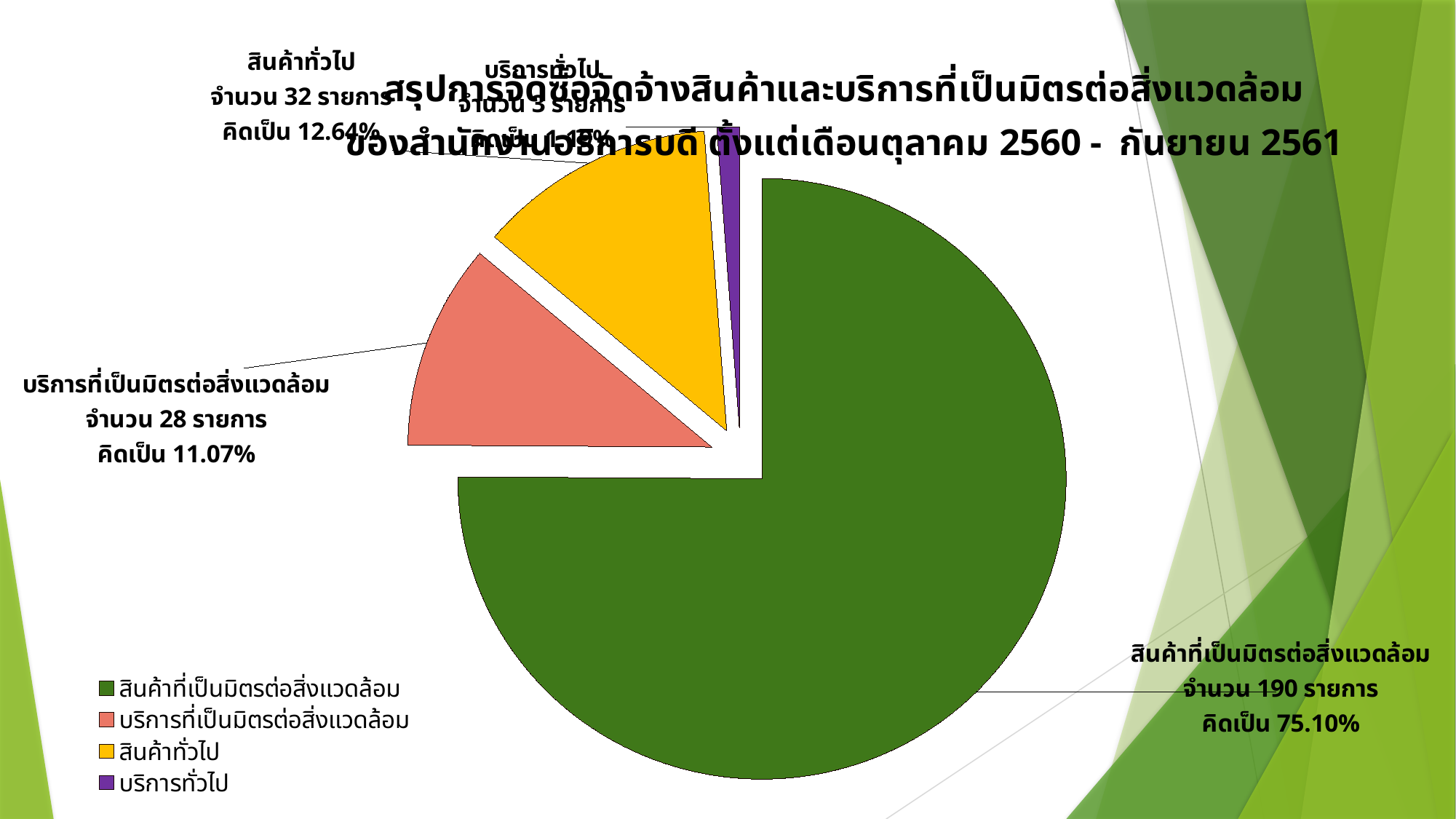
What percentage share is shown for สินค้าที่เป็นมิตรต่อสิ่งแวดล้อม? 75.10% What percentage share is shown for บริการที่เป็นมิตรต่อสิ่งแวดล้อม? 11.07% Which category has the smallest slice of the pie? บริการทั่วไป How many items (รายการ) are shown for สินค้าทั่วไป? 32 รายการ Which category has the largest slice of the pie? สินค้าที่เป็นมิตรต่อสิ่งแวดล้อม How many items (รายการ) are shown for บริการที่เป็นมิตรต่อสิ่งแวดล้อม? 28 รายการ How many entries does the legend list? 4 What type of chart is shown on the slide? Pie chart What is the difference in number of items between สินค้าทั่วไป and บริการที่เป็นมิตรต่อสิ่งแวดล้อม? 4 รายการ How many items (รายการ) are shown for สินค้าที่เป็นมิตรต่อสิ่งแวดล้อม? 190 รายการ What percentage share is shown for สินค้าทั่วไป? 12.64% How many slices does the pie chart have? 4